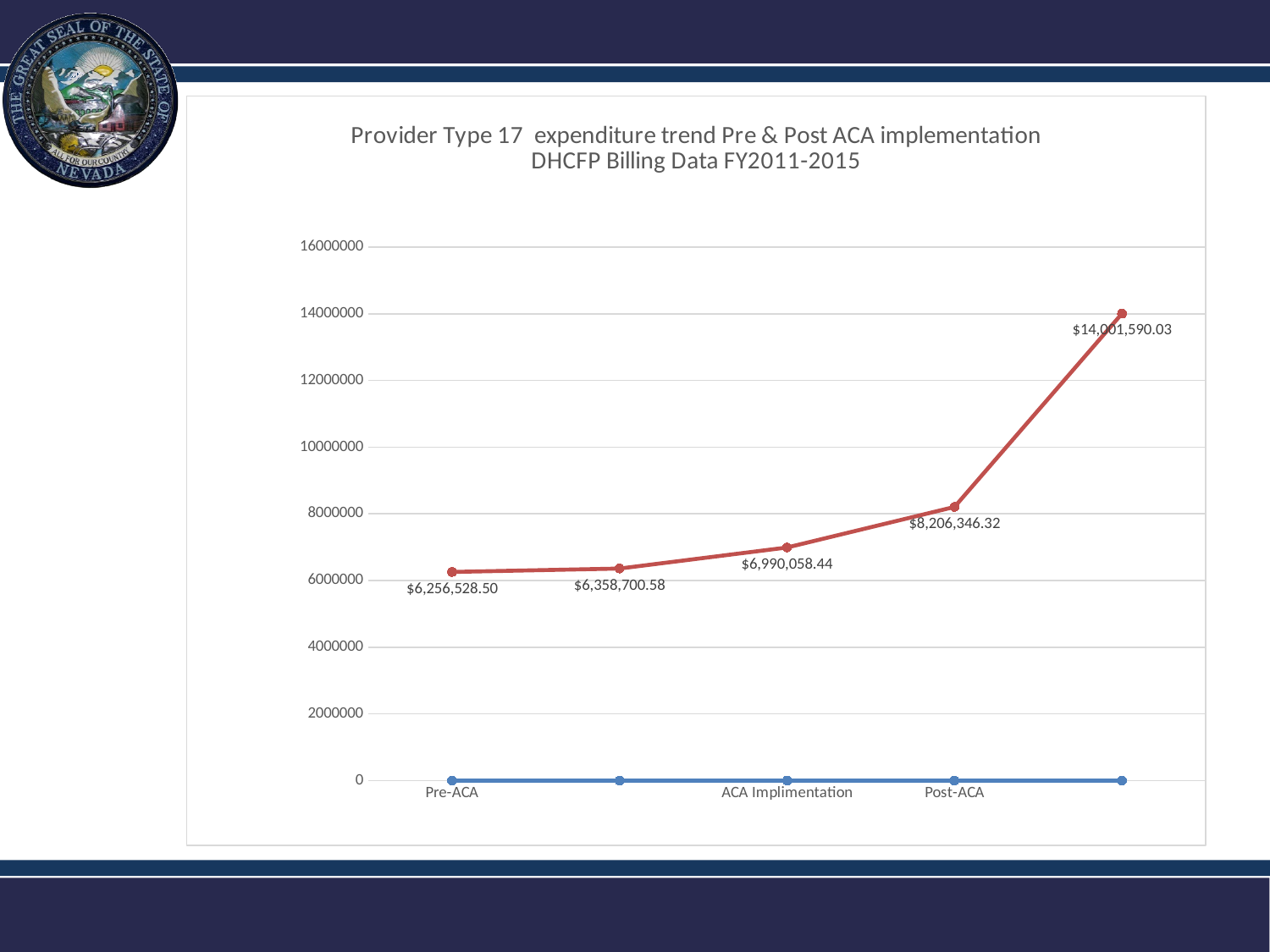
What is the expenditure value for Post-ACA? $8,206,346.32 What kind of chart is shown on the slide? line chart What is the difference between the Post-ACA value and the ACA Implimentation value? $1,216,287.88 Is the value for Pre-ACA greater or less than 8000000? less What is the expenditure value for Pre-ACA? $6,256,528.50 What is the difference between the Post-ACA value and the Pre-ACA value? $1,949,817.82 What is the expenditure value for ACA Implimentation? $6,990,058.44 What is the highest expenditure value plotted on the chart? $14,001,590.03 Which labelled category has the lowest expenditure value? Pre-ACA Which is larger, the value for Post-ACA or the value for ACA Implimentation? Post-ACA How many data points are plotted on the red expenditure line? 5 Do the expenditure values rise or fall from left to right along the x axis? rise